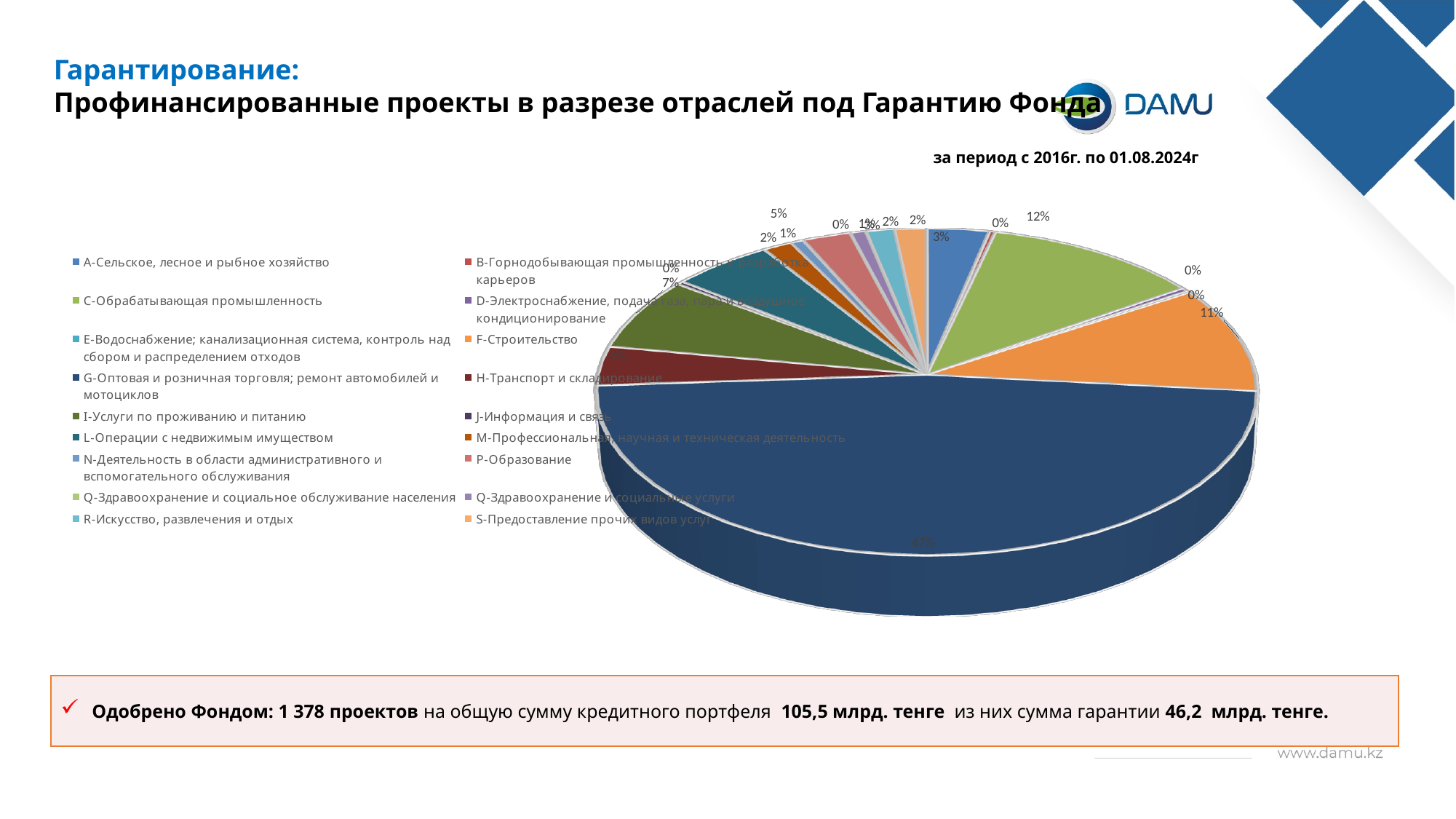
Which has the larger share: I-Услуги по проживанию и питанию or A-Сельское, лесное и рыбное хозяйство? I-Услуги по проживанию и питанию What is the difference in share between I-Услуги по проживанию и питанию and A-Сельское, лесное и рыбное хозяйство? 4% What kind of chart is shown on the slide? pie chart What share of the pie does I-Услуги по проживанию и питанию have? 7% What share of the pie does F-Строительство have? 11% What share of the pie does A-Сельское, лесное и рыбное хозяйство have? 3% What period does the chart cover, according to the text above it? за период с 2016г. по 01.08.2024г Which category has the largest slice of the pie chart? G-Оптовая и розничная торговля; ремонт автомобилей и мотоциклов What is the difference in share between C-Обрабатывающая промышленность and F-Строительство? 1% How many categories does the legend of the pie chart list? 18 Which has the larger share: C-Обрабатывающая промышленность or F-Строительство? C-Обрабатывающая промышленность